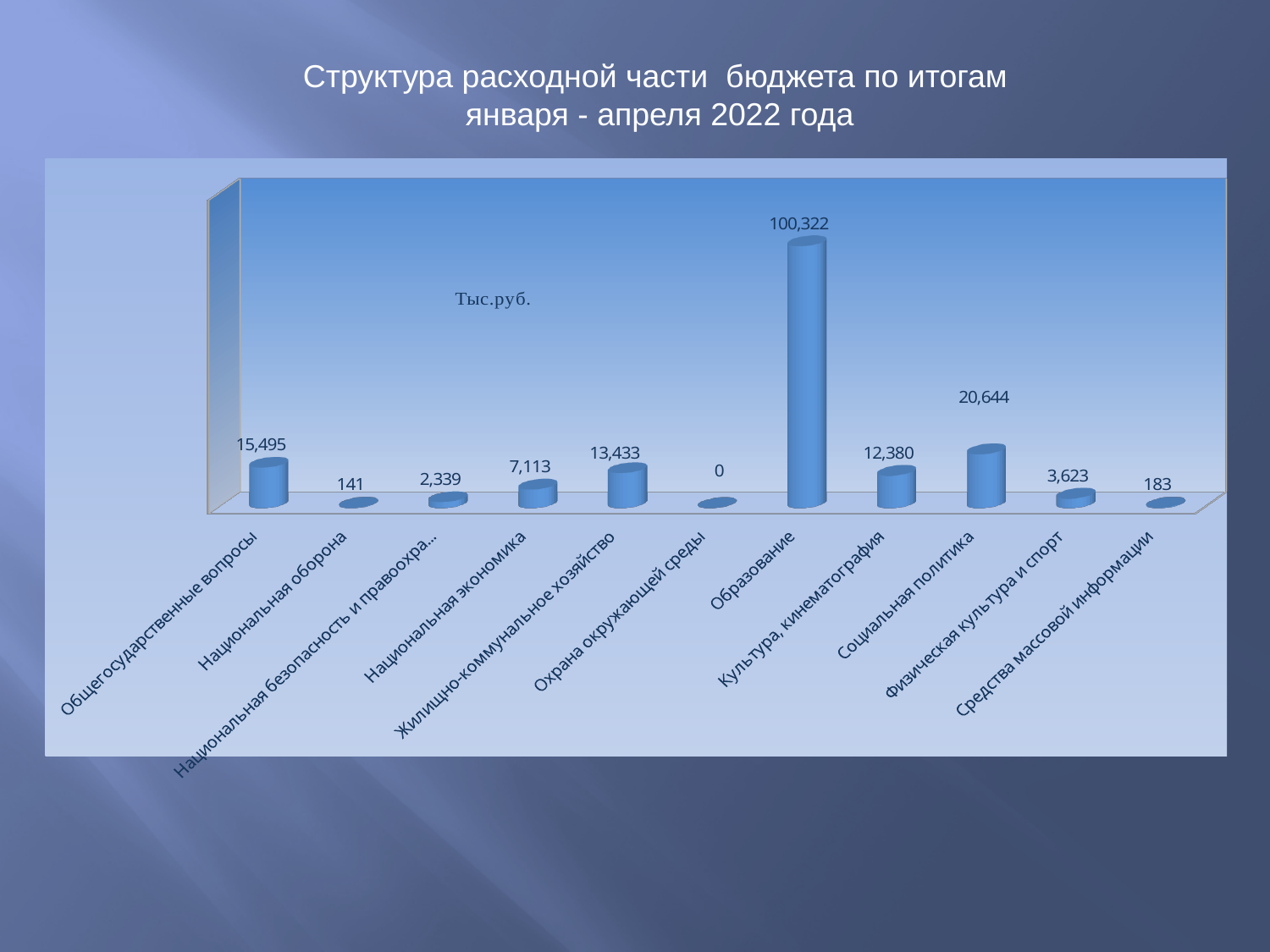
Which category has the highest value? Образование What unit is indicated on the chart? Тыс.руб. How many categories are shown on the chart? 11 Which is larger, the value for Культура, кинематография or the value for Национальная экономика? Культура, кинематография What kind of chart is shown on the slide? Bar chart What is the difference between the values for Социальная политика and Общегосударственные вопросы? 5,149 What is the difference between the values for Физическая культура и спорт and Средства массовой информации? 3,440 What is the value for Образование? 100,322 Which category has the lowest value? Охрана окружающей среды What is the value for Социальная политика? 20,644 What is the value for Жилищно-коммунальное хозяйство? 13,433 What is the value for Национальная оборона? 141